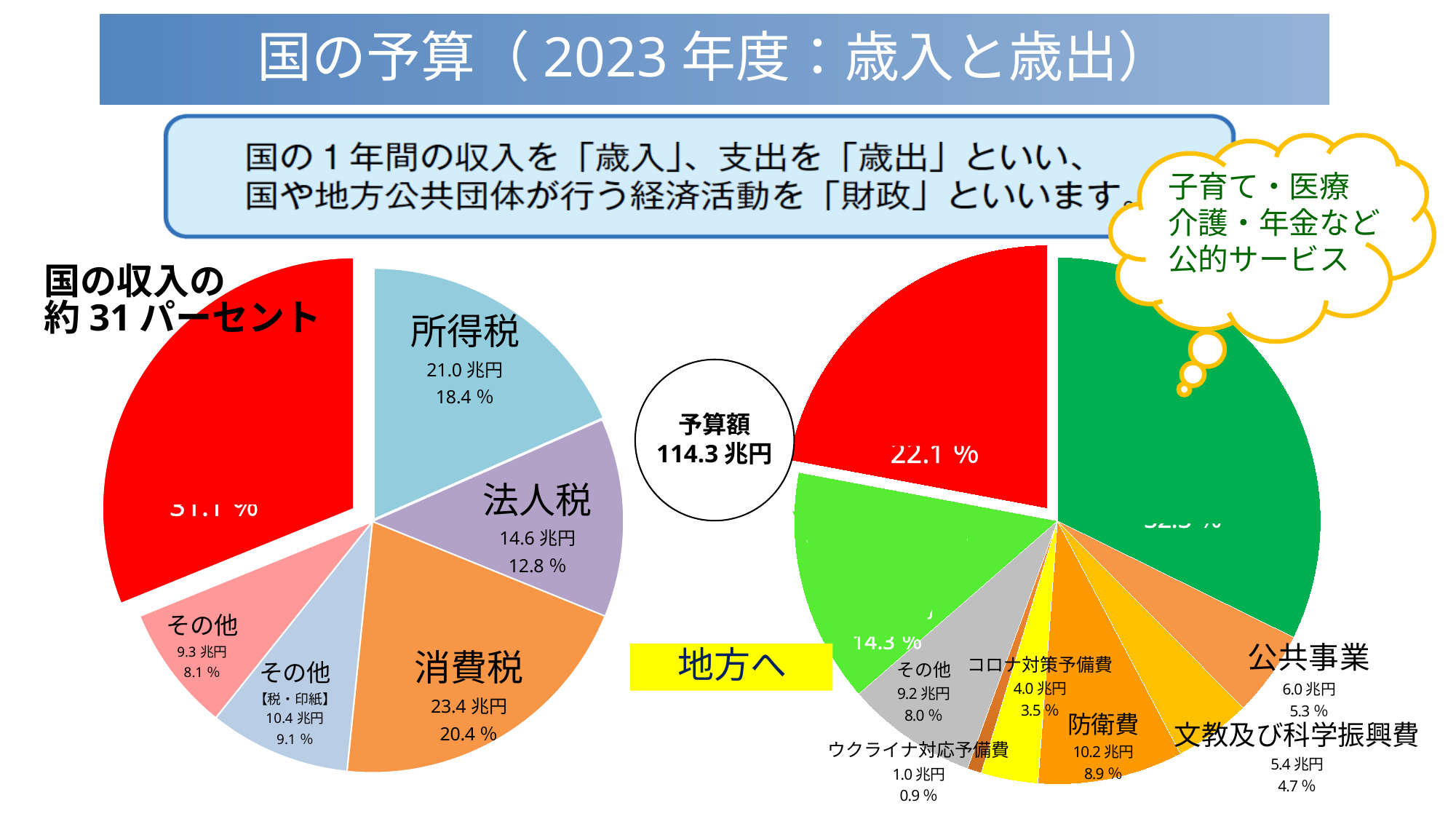
On the right pie chart, what is the value shown for ウクライナ対応予備費? 1.0 兆円 On the right pie chart, which is larger, 防衛費 or 文教及び科学振興費? 防衛費 On the left pie chart, what is the difference in 兆円 between 消費税 and 法人税? 8.8 兆円 On the left pie chart, what is the value shown for 法人税? 14.6 兆円 On the right pie chart, what percentage share is shown for 公共事業? 5.3 % On the left pie chart, which is larger, 消費税 or 所得税? 消費税 On the left pie chart, what percentage share is shown for 所得税? 18.4 % On the right pie chart, what is the value shown for 防衛費? 10.2 兆円 What kind of charts are shown on the slide? Pie charts On the left pie chart, what is the value shown for 消費税? 23.4 兆円 What total budget amount (予算額) is shown in the circle between the two pie charts? 114.3 兆円 On the right pie chart, what is the difference in 兆円 between コロナ対策予備費 and ウクライナ対応予備費? 3.0 兆円